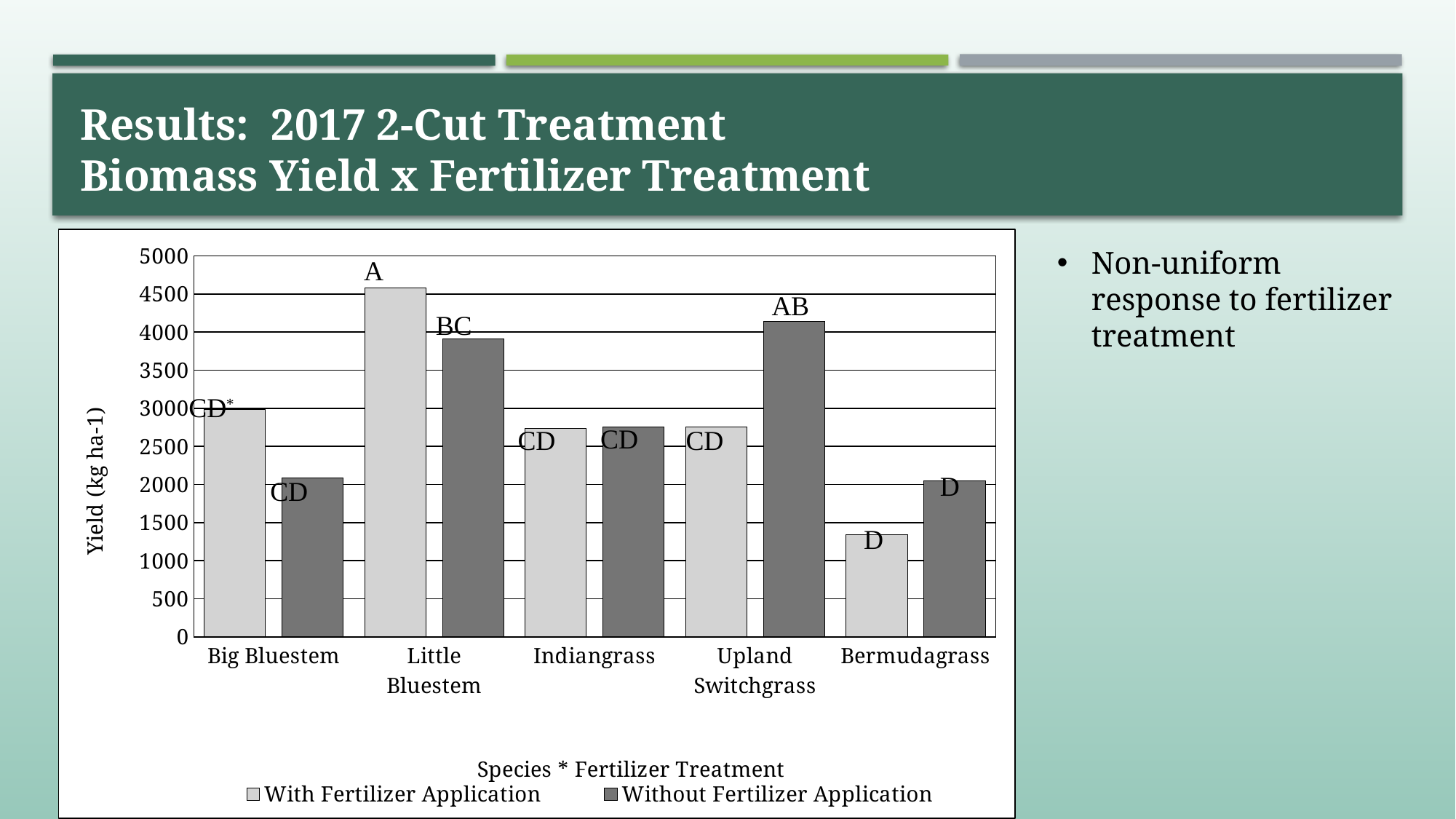
Which species has the highest yield With Fertilizer Application? Little Bluestem What kind of chart is shown on the slide? bar chart How many species categories are shown on the x axis? 5 For Upland Switchgrass, which is larger: the yield With Fertilizer Application or Without Fertilizer Application? Without Fertilizer Application Which species has the lowest yield With Fertilizer Application? Bermudagrass Which species has the highest yield Without Fertilizer Application? Upland Switchgrass Is the yield for Bermudagrass With Fertilizer Application greater or less than 1500? less For Big Bluestem, which is larger: the yield With Fertilizer Application or Without Fertilizer Application? With Fertilizer Application What is the title of the y axis? Yield (kg ha-1) Which species has the lowest yield Without Fertilizer Application? Bermudagrass How many series does the legend list? 2 Is the yield for Little Bluestem With Fertilizer Application greater or less than 4000? greater